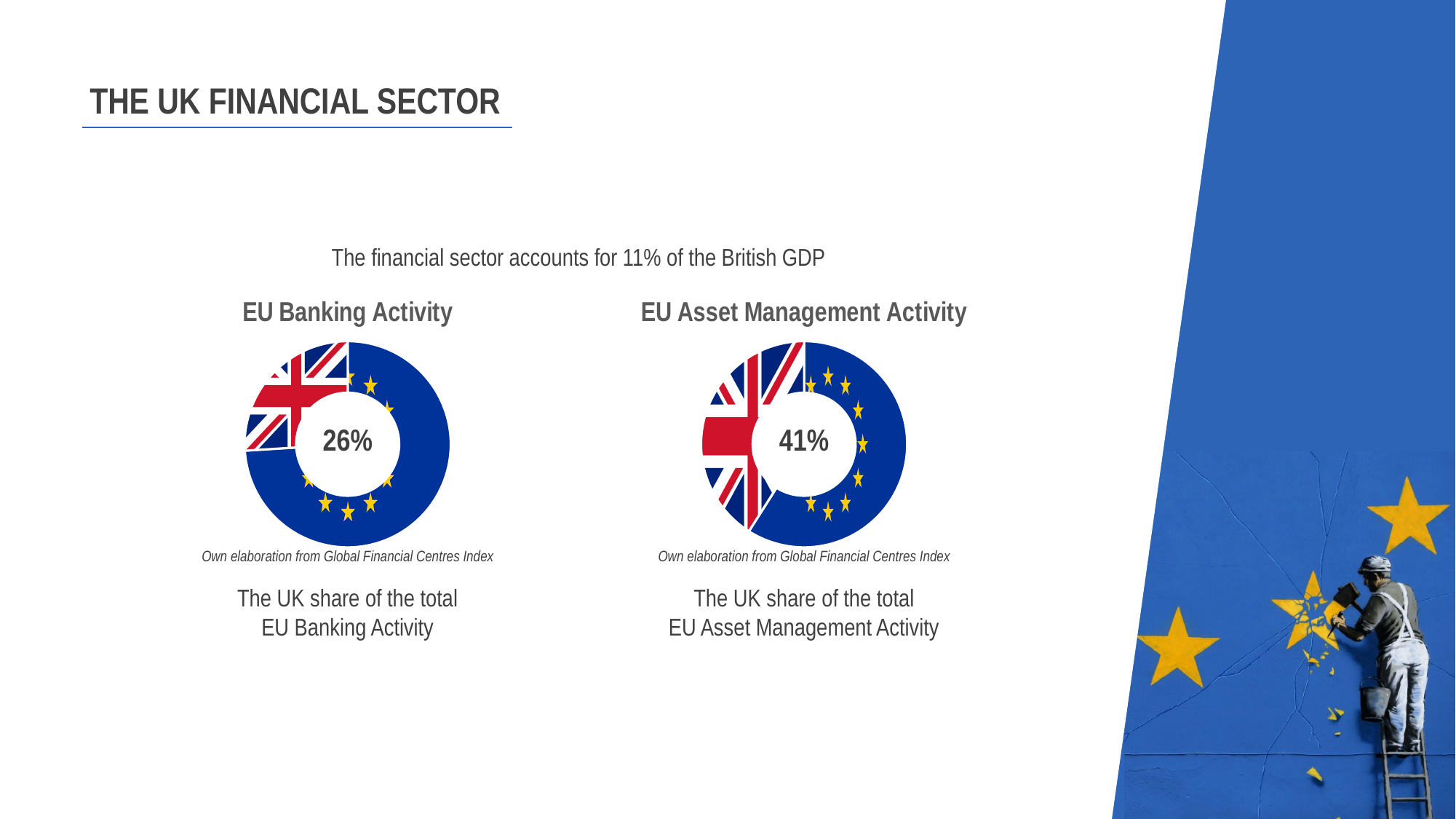
In the EU Banking Activity chart, is the UK share greater or less than 50%? less What kind of chart is the EU Banking Activity chart? Donut (pie) chart What source is cited below the EU Asset Management Activity chart? Own elaboration from Global Financial Centres Index In the EU Asset Management Activity chart, what is the UK share of the total EU asset management activity? 41% How many charts are shown on the slide? 2 What is the title of the chart on the left of the slide? EU Banking Activity By how many percentage points does the UK share in the EU Asset Management Activity chart exceed the UK share in the EU Banking Activity chart? 15 percentage points How many slices does the EU Banking Activity chart have? 2 In the EU Banking Activity chart, what is the UK share of the total EU banking activity? 26% Which chart shows a larger UK share: EU Banking Activity or EU Asset Management Activity? EU Asset Management Activity In the EU Asset Management Activity chart, is the UK share greater or less than 50%? less What kind of chart is the EU Asset Management Activity chart? Donut (pie) chart